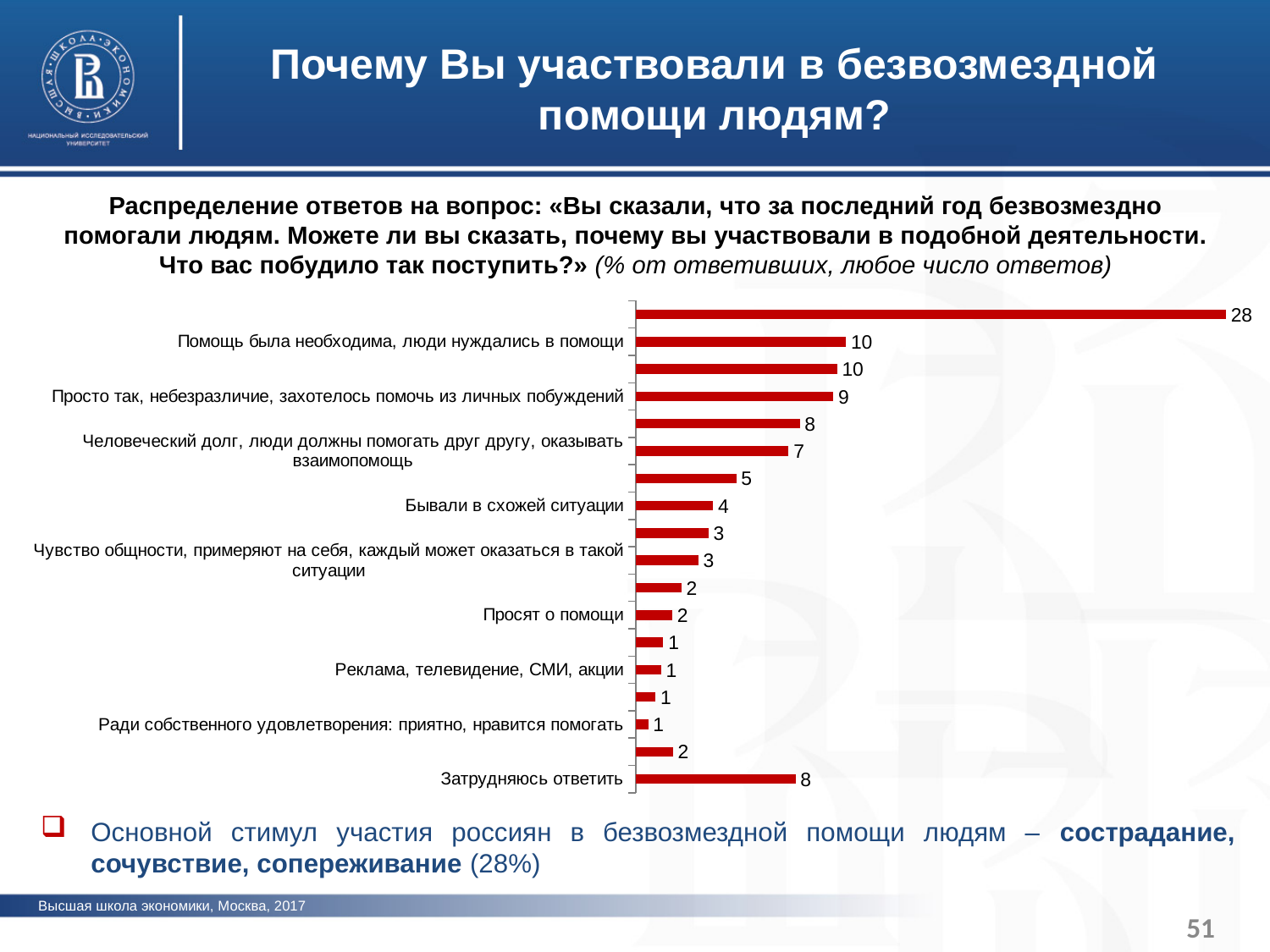
What is the value for "Бывали в схожей ситуации"? 4 Which is larger: the value for "Затрудняюсь ответить" or the value for "Человеческий долг, люди должны помогать друг другу, оказывать взаимопомощь"? Затрудняюсь ответить What is the value for "Человеческий долг, люди должны помогать друг другу, оказывать взаимопомощь"? 7 What is the value for "Затрудняюсь ответить"? 8 What kind of chart is shown on the slide? bar chart What is the value for "Реклама, телевидение, СМИ, акции"? 1 What is the value for "Просто так, небезразличие, захотелось помочь из личных побуждений"? 9 How many bars are plotted in the chart? 18 What is the value for "Помощь была необходима, люди нуждались в помощи"? 10 What colour are the bars in the chart? red What is the difference between the values for "Помощь была необходима, люди нуждались в помощи" and "Бывали в схожей ситуации"? 6 What is the highest value plotted in the chart? 28